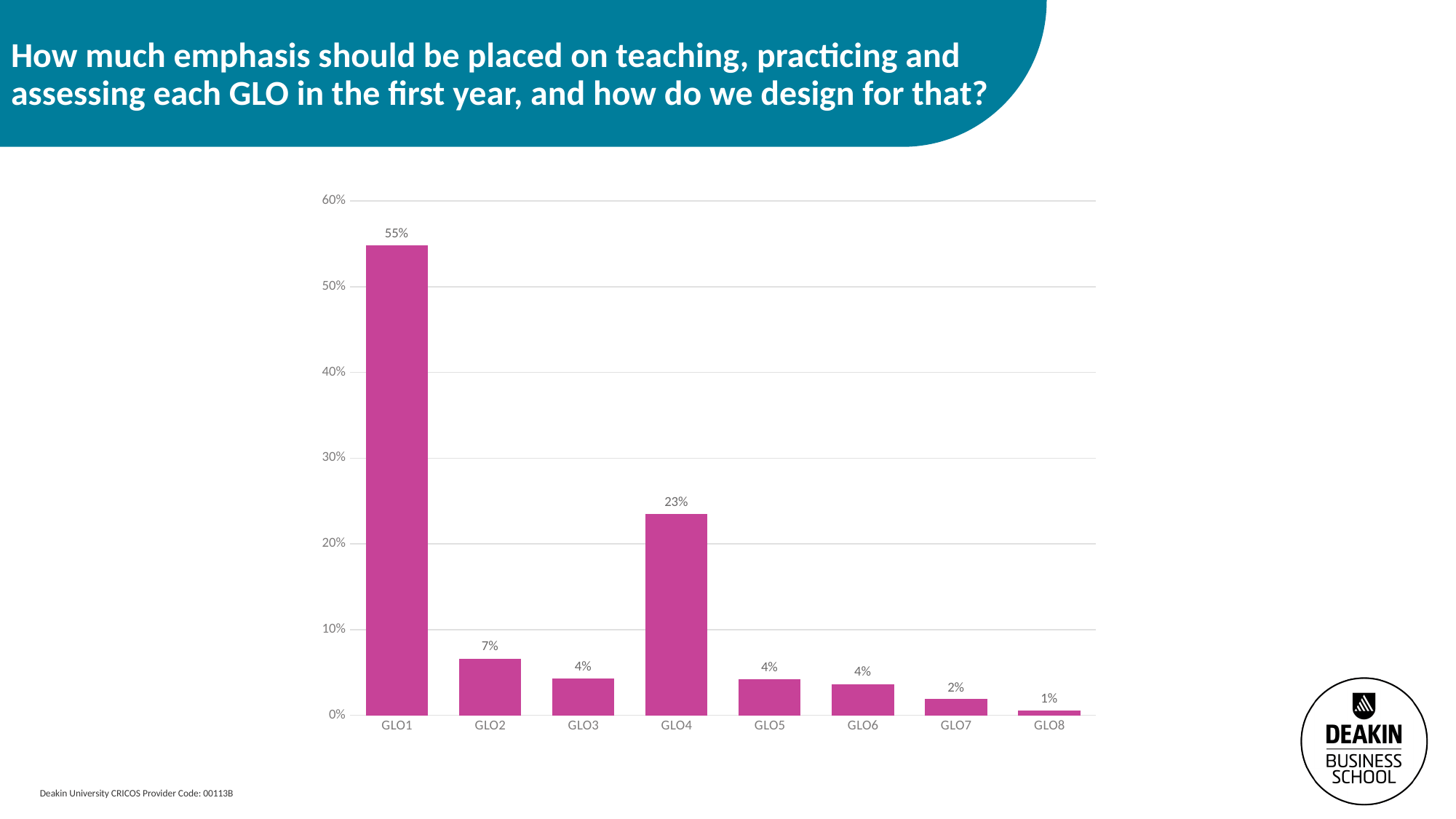
What is the difference between the values for GLO1 and GLO4? 32% How many categories are shown on the x axis? 8 Is the value for GLO4 greater or less than 20%? greater What kind of chart is shown on the slide? Bar chart Which category has the lowest value? GLO8 What is the value for GLO4? 23% What is the difference between the values for GLO2 and GLO3? 3% Which is larger, the value for GLO2 or the value for GLO6? GLO2 What is the value for GLO1? 55% Which category has the highest value? GLO1 What colour are the bars in the chart? Magenta (pink) What is the value for GLO7? 2%